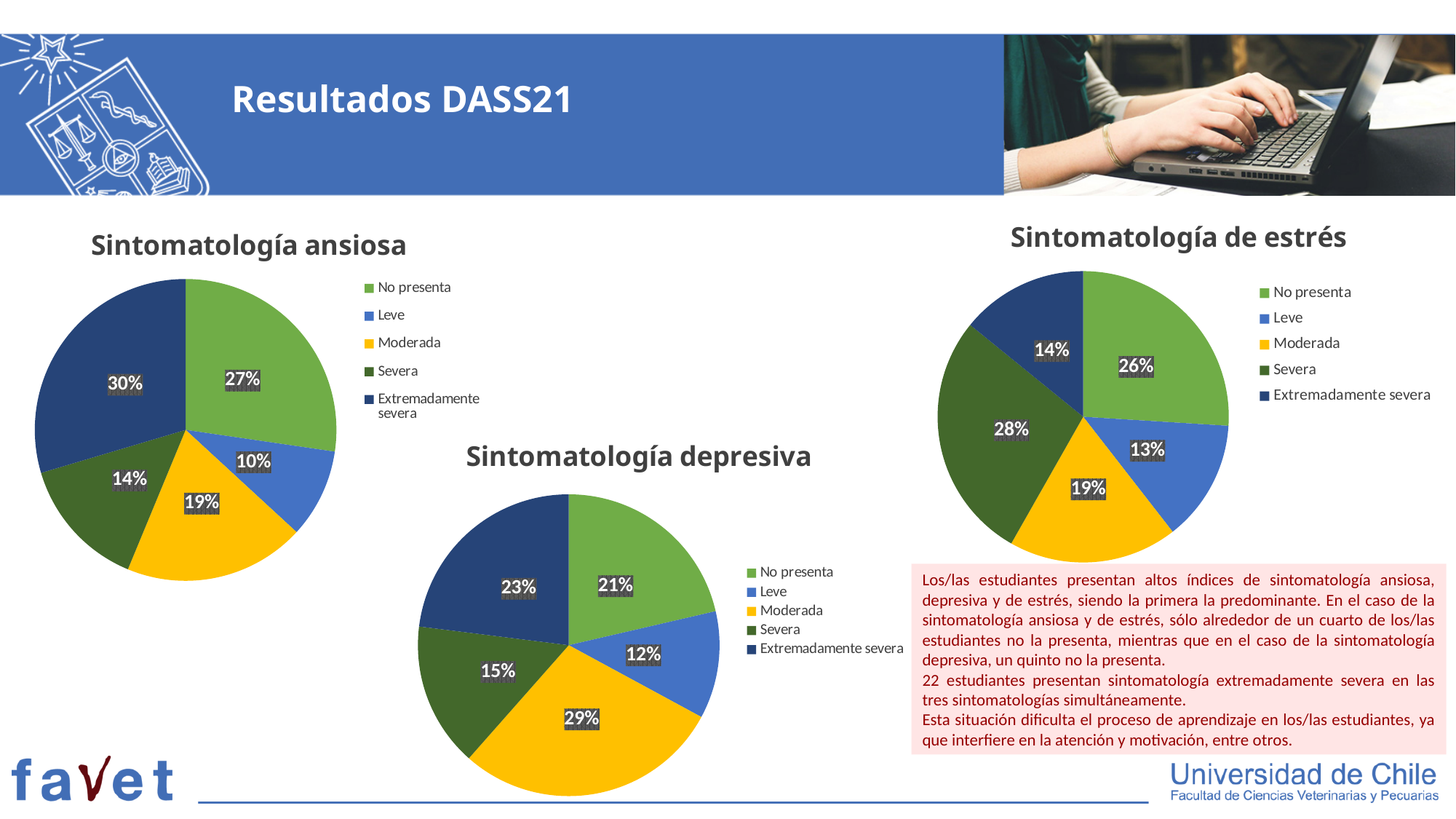
In the 'Sintomatología depresiva' chart, what share is labelled for 'Moderada'? 29% How many categories does the legend of the 'Sintomatología de estrés' chart list? 5 In the 'Sintomatología ansiosa' chart, which category has the smallest slice? Leve In the 'Sintomatología depresiva' chart, which is larger, 'No presenta' or 'Extremadamente severa'? Extremadamente severa In the 'Sintomatología ansiosa' chart, what share is labelled for 'Extremadamente severa'? 30% What type of chart is 'Sintomatología depresiva'? Pie chart In the 'Sintomatología ansiosa' chart, which colour represents 'Moderada'? Yellow In the 'Sintomatología depresiva' chart, which category has the largest slice? Moderada In the 'Sintomatología ansiosa' chart, what is the difference between the 'No presenta' and 'Leve' shares? 17% In the 'Sintomatología de estrés' chart, what is the difference between the 'Severa' and 'Extremadamente severa' shares? 14% In the 'Sintomatología de estrés' chart, which category has the smallest slice? Leve In the 'Sintomatología de estrés' chart, what share is labelled for 'Severa'? 28%